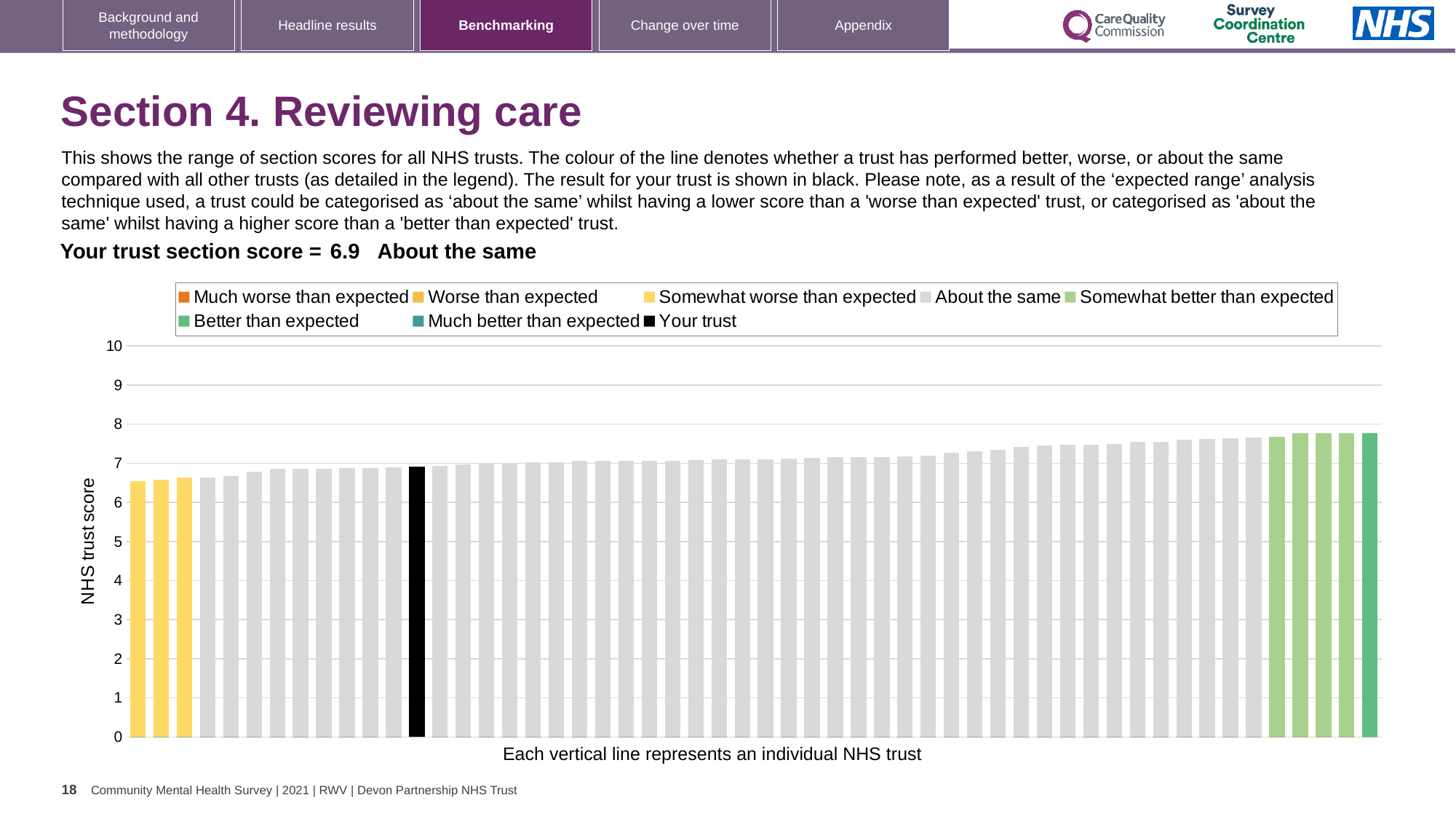
What colour is the bar representing your trust? black What kind of chart is shown on the slide? bar chart Do the bar values rise or fall from left to right along the x axis? rise How many entries does the chart legend list? 8 Is the value of the tallest bar in the chart greater or less than 8? less Is the value of the shortest bar in the chart greater or less than 6? greater Is the value of the black 'Your trust' bar greater or less than 5? greater Which legend category does the tallest bar in the chart belong to? Better than expected What is the label on the y axis of the chart? NHS trust score How many bars in the chart are coloured yellow? 3 Which category is your trust placed in for this section? About the same What is the section score for your trust shown on the slide? 6.9